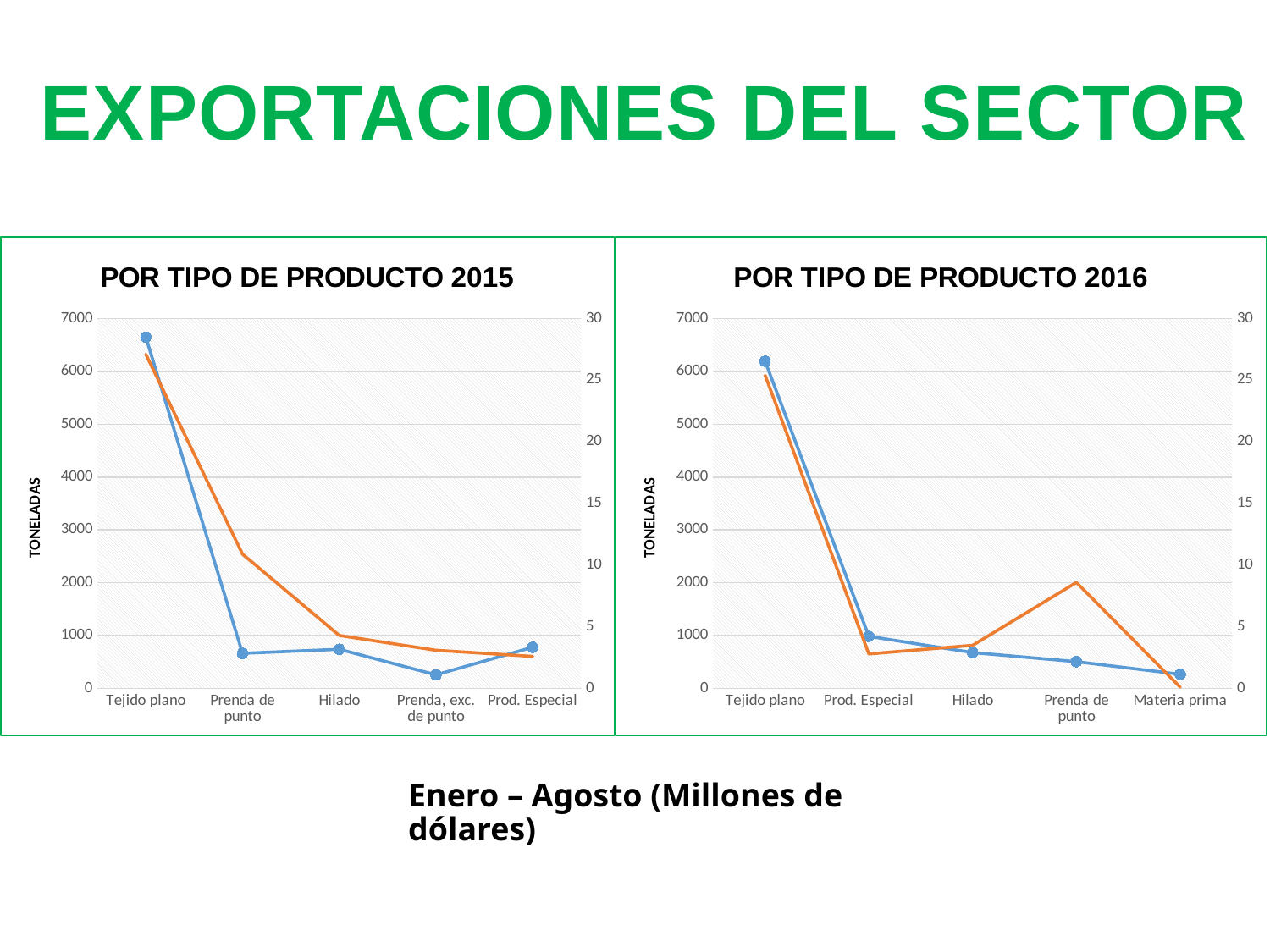
In 'POR TIPO DE PRODUCTO 2015', which category has the highest value on the blue line? Tejido plano In 'POR TIPO DE PRODUCTO 2015', is the blue line value for Tejido plano greater or less than 6000? greater In 'POR TIPO DE PRODUCTO 2016', does the blue line rise or fall from Tejido plano to Materia prima? Fall In 'POR TIPO DE PRODUCTO 2015', is the blue line value for Prenda de punto greater or less than 1000? less How many product categories are shown on the x axis of 'POR TIPO DE PRODUCTO 2016'? 5 In 'POR TIPO DE PRODUCTO 2016', is the blue line value for Materia prima greater or less than 1000? less What is the label on the left vertical axis of 'POR TIPO DE PRODUCTO 2015'? TONELADAS What kind of chart is 'POR TIPO DE PRODUCTO 2015'? Line chart In 'POR TIPO DE PRODUCTO 2016', which has the larger blue line value, Prod. Especial or Prenda de punto? Prod. Especial In 'POR TIPO DE PRODUCTO 2015', which category has the lowest value on the blue line? Prenda, exc. de punto In 'POR TIPO DE PRODUCTO 2016', which category has the lowest value on the blue line? Materia prima